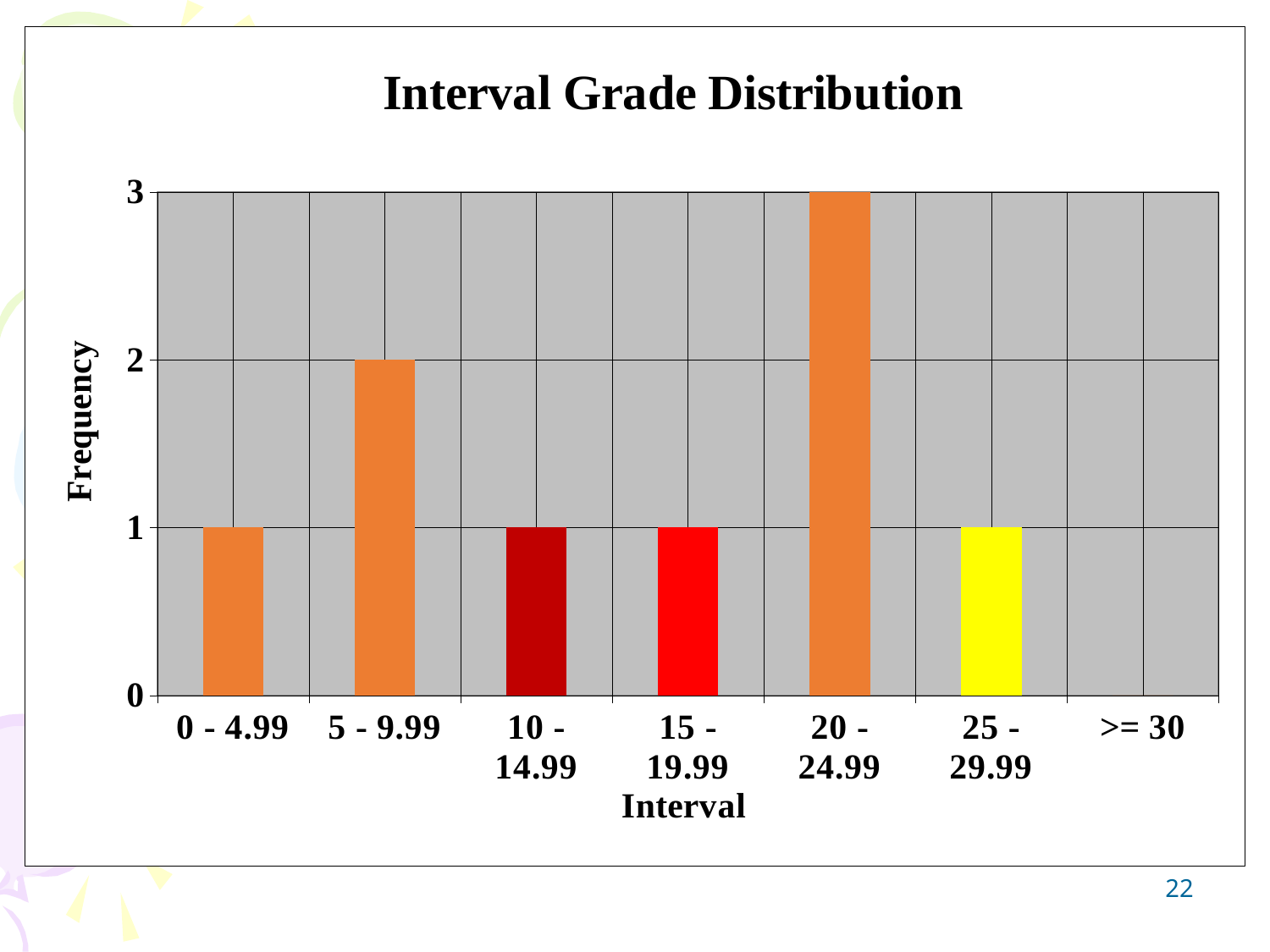
Which interval has a higher frequency, 5 - 9.99 or 15 - 19.99? 5 - 9.99 Which interval has the highest frequency? 20 - 24.99 What is the title of the chart? Interval Grade Distribution What is the frequency for the interval 0 - 4.99? 1 How many intervals are shown on the x axis? 7 What is the label of the vertical axis? Frequency What is the frequency for the interval >= 30? 0 What type of chart is shown on the slide? bar chart Which interval has the lowest frequency? >= 30 What is the difference in frequency between the intervals 20 - 24.99 and 5 - 9.99? 1 What is the frequency for the interval 5 - 9.99? 2 What is the frequency for the interval 20 - 24.99? 3